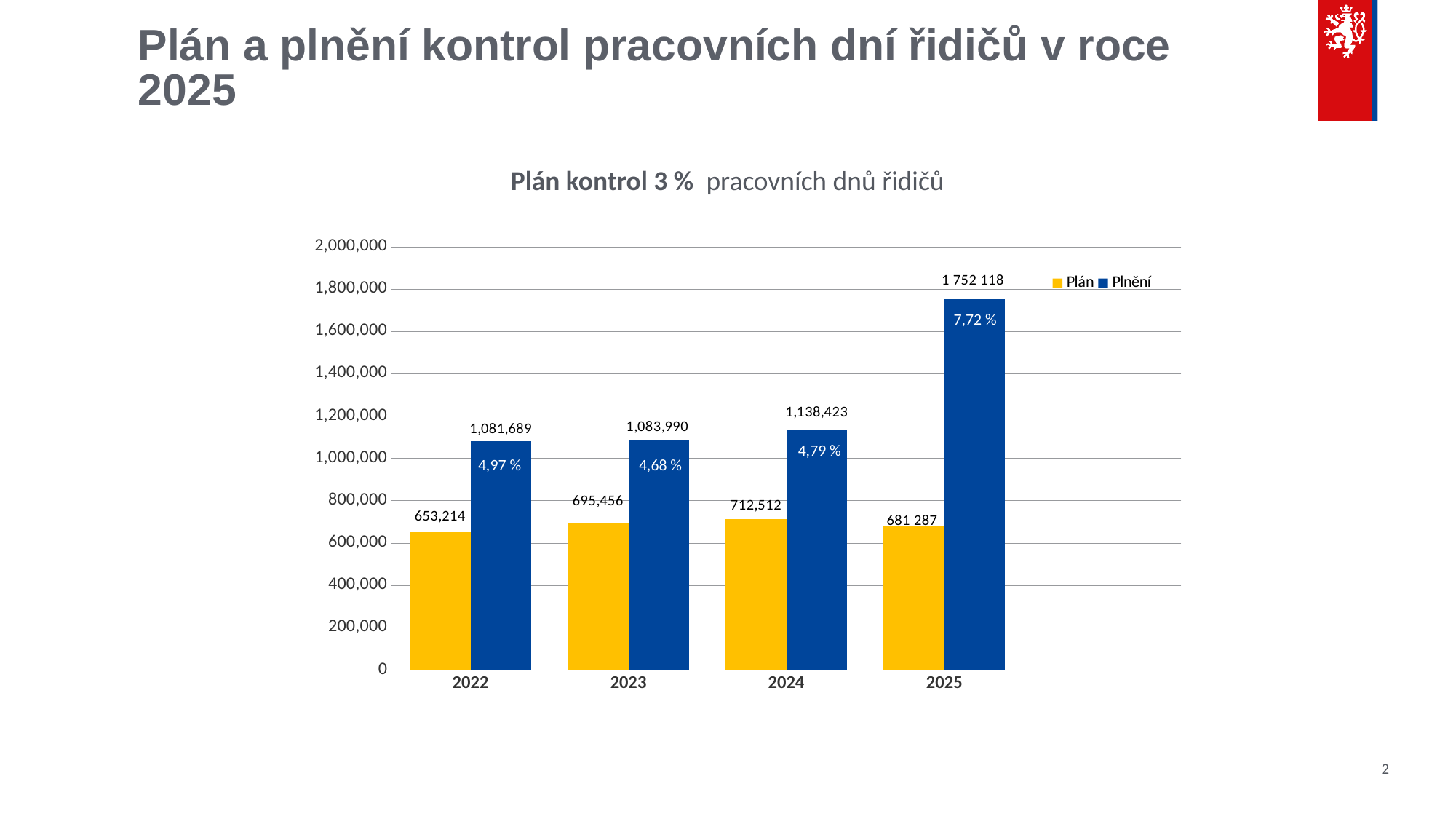
In which year is the Plnění value highest? 2025 Is the Plnění value for 2024 greater or less than 1,000,000? greater What is the value of Plán for 2022? 653,214 How many series does the legend list? 2 How many years are shown on the x axis? 4 What is the difference between Plnění and Plán in 2022? 428,475 What kind of chart is shown on the slide? bar chart What is the value of Plnění for 2025? 1 752 118 What percentage is shown inside the Plnění bar for 2023? 4,68 % Which is larger, the Plán value for 2023 or for 2024? 2024 In which year is the Plán value lowest? 2022 Does the Plnění value rise or fall from 2022 to 2025? rise